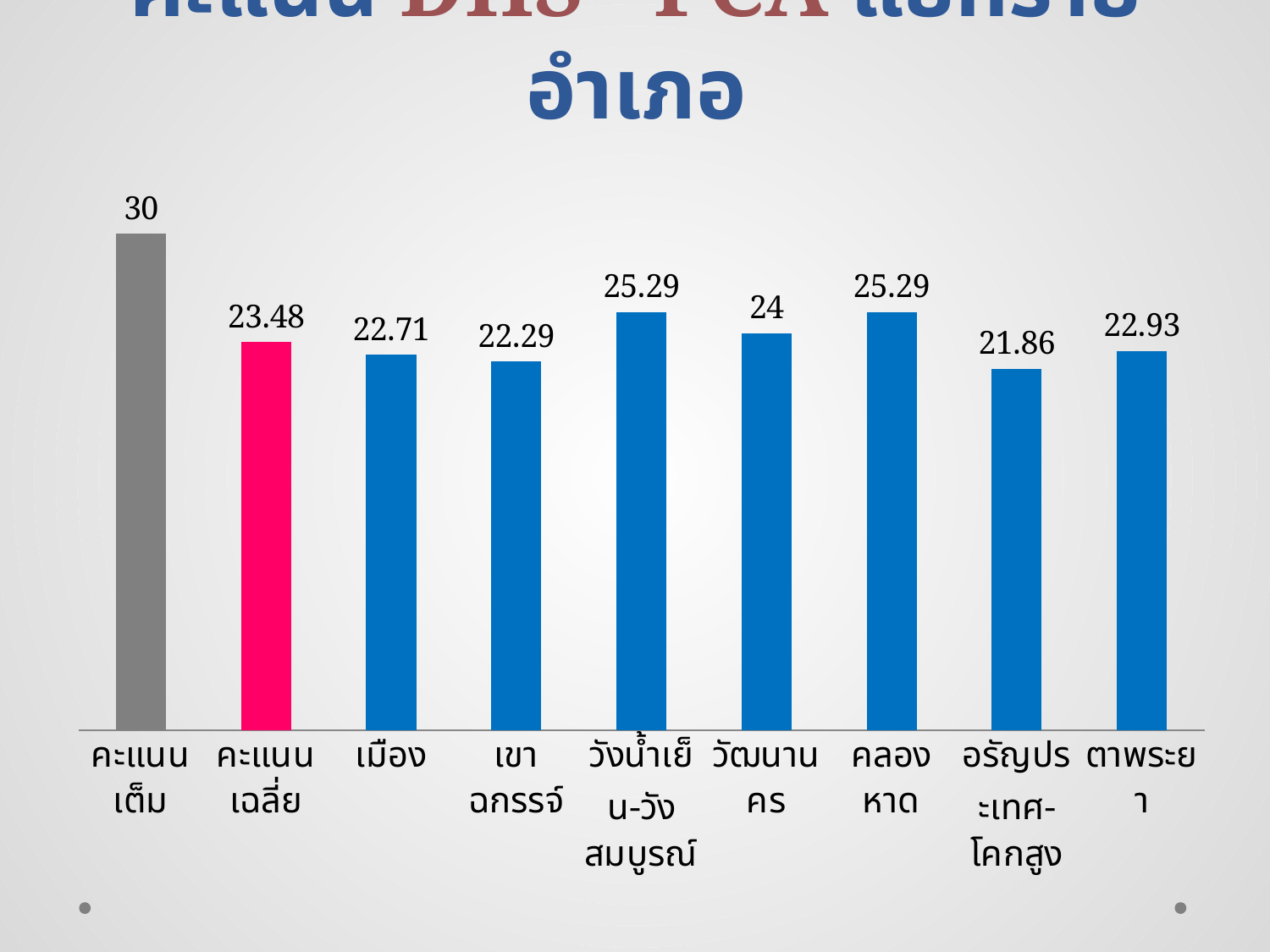
What is the value for คะแนนเฉลี่ย? 23.48 How many bars are shown in the chart? 9 Which category has the lowest value? อรัญประเทศ-โคกสูง Which category has the highest value? คะแนนเต็ม What is the difference between the values for คะแนนเต็ม and คะแนนเฉลี่ย? 6.52 What is the value for เมือง? 22.71 What is the value for วัฒนานคร? 24 Which is larger, the value for คลองหาด or the value for เมือง? คลองหาด What is the value for คะแนนเต็ม? 30 What is the value for ตาพระยา? 22.93 What kind of chart is shown on the slide? Bar chart What is the difference between the values for วัฒนานคร and เขาฉกรรจ์? 1.71